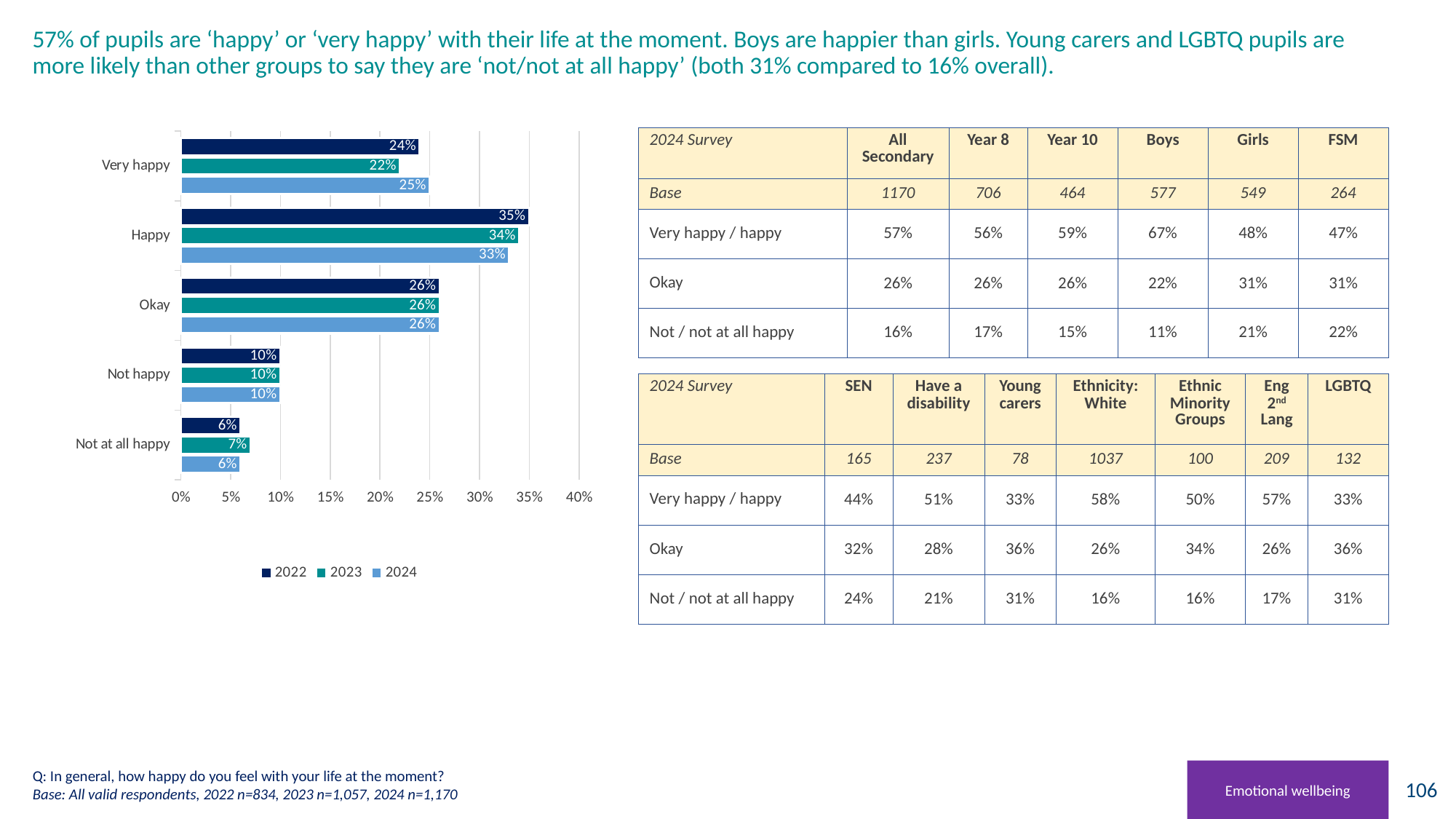
What kind of chart is shown on the slide? Bar chart Is the 2023 value for 'Happy' greater or less than 30%? greater How many series does the legend list? 3 What is the 2022 value for 'Happy'? 35% Which category has the lowest value for the 2022 series? Not at all happy What is the 2023 value for 'Not at all happy'? 7% What is the difference between the 2022 and 2024 values for 'Happy'? 2% Which is larger: the 2022 value for 'Very happy' or the 2024 value for 'Very happy'? 2024 What is the 2024 value for 'Very happy'? 25% Which category has the highest value for the 2024 series? Happy How many categories are shown on the chart? 5 What are the series names listed in the chart legend? 2022, 2023, 2024